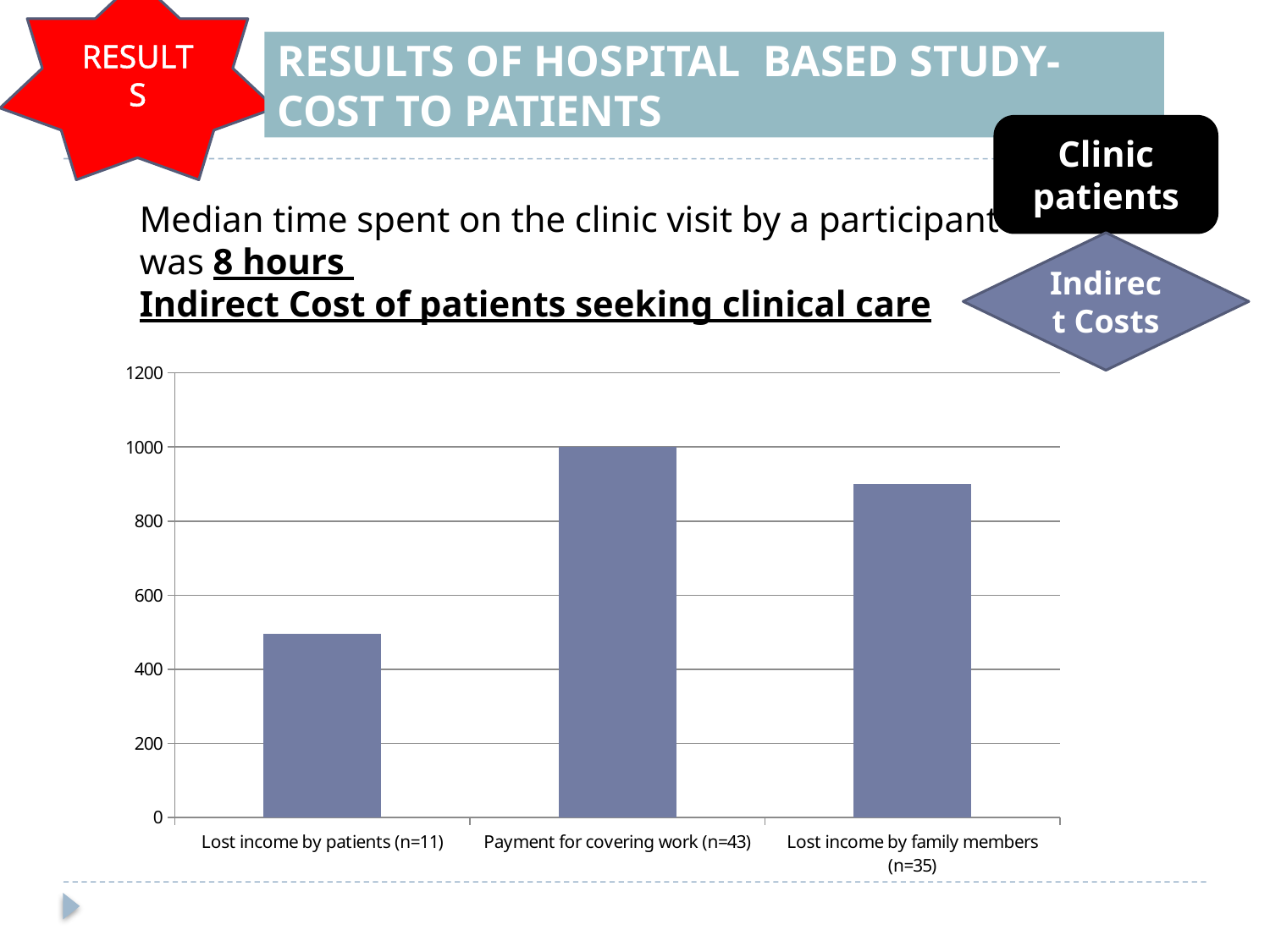
Which is larger: the value for Payment for covering work (n=43) or the value for Lost income by family members (n=35)? Payment for covering work (n=43) Is the value for Lost income by patients (n=11) greater or less than 400? greater Which is larger: the value for Lost income by patients (n=11) or the value for Lost income by family members (n=35)? Lost income by family members (n=35) What is the maximum value shown on the vertical axis of the chart? 1200 What type of chart is shown on the slide? bar chart Which category has the highest value? Payment for covering work (n=43) Is the value for Lost income by family members (n=35) greater or less than 1000? less Is the value for Lost income by family members (n=35) greater or less than 800? greater Which category has the lowest value? Lost income by patients (n=11) How many categories are plotted in the bar chart? 3 What is the value for Payment for covering work (n=43)? 1000